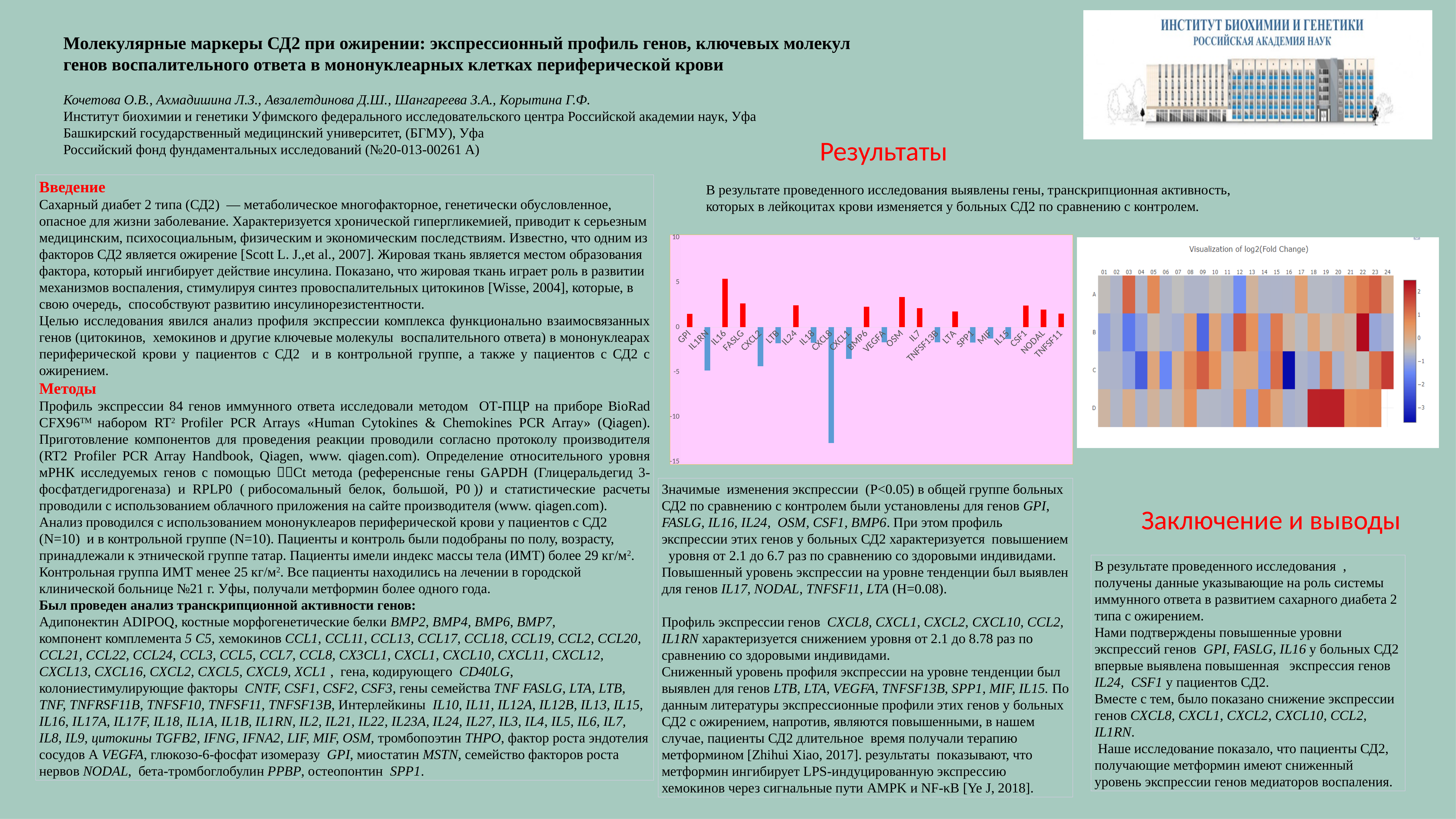
In the bar chart on the pink background, which gene has the lowest bar? CXCL8 In the bar chart on the pink background, what kind of chart is it? bar chart In the bar chart on the pink background, is the value for CXCL8 greater or less than -10? less In the bar chart on the pink background, is the value for OSM greater or less than 0? greater What is the title of the heatmap on the right side of the slide? Visualization of log2(Fold Change) In the bar chart on the pink background, how many genes are shown on the x axis? 22 In the bar chart on the pink background, what colour are the bars with negative values? blue In the bar chart on the pink background, is the value for IL16 greater or less than 0? greater In the bar chart on the pink background, which is larger, the value for OSM or the value for GPI? OSM In the bar chart on the pink background, which gene has the highest bar? IL16 In the bar chart on the pink background, which is larger, the value for IL16 or the value for FASLG? IL16